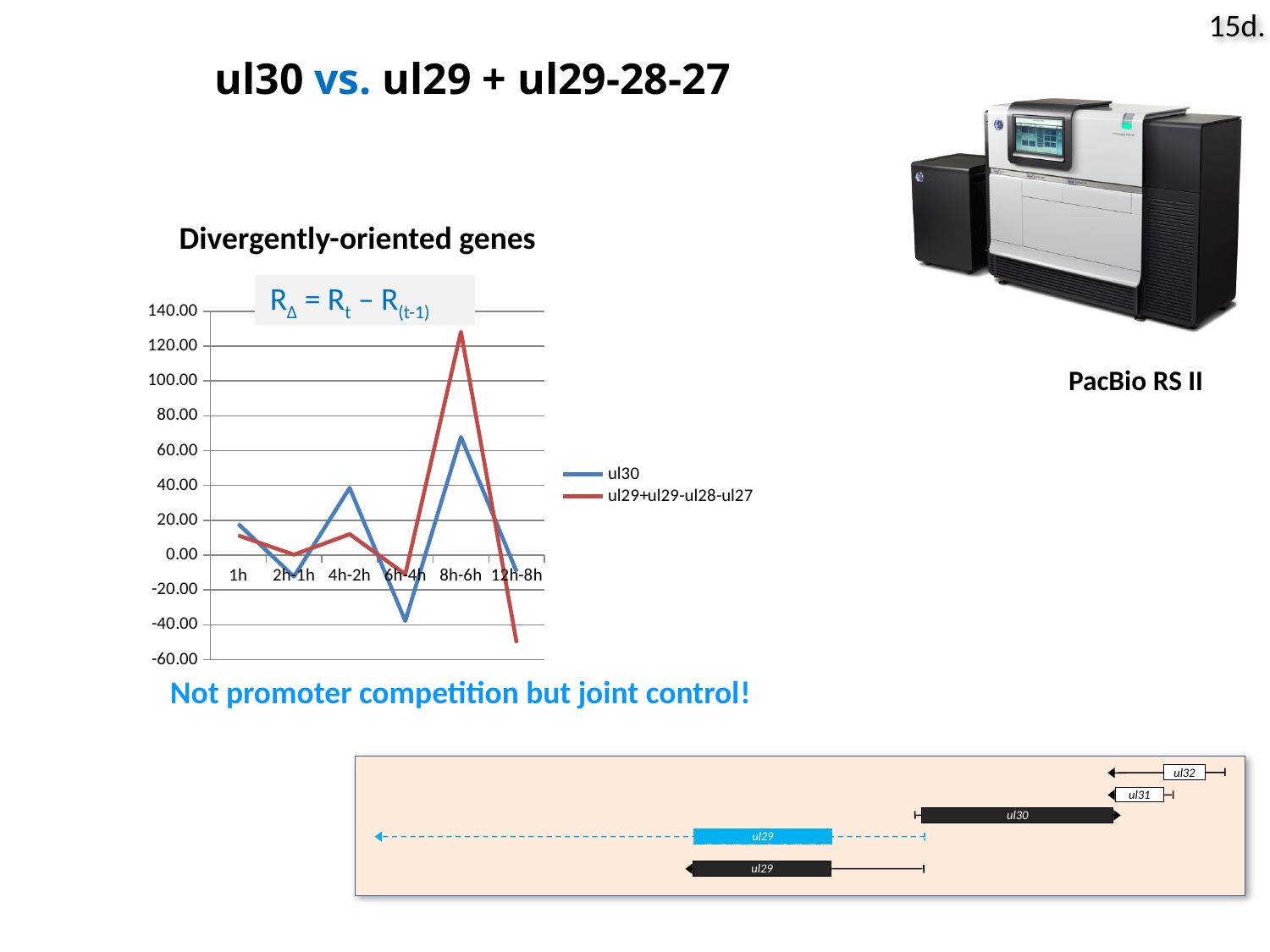
Is the value of ul29+ul29-ul28-ul27 at 8h-6h greater or less than 100.00? greater What kind of chart is shown under the heading "Divergently-oriented genes"? line chart At which x-axis category does the ul29+ul29-ul28-ul27 series reach its lowest value? 12h-8h At 8h-6h, which series has the higher value, ul30 or ul29+ul29-ul28-ul27? ul29+ul29-ul28-ul27 Is the value of ul30 at 4h-2h greater or less than 20.00? greater How many categories are shown on the x axis of the line chart? 6 Which series in the line chart is drawn in red? ul29+ul29-ul28-ul27 How many series does the legend of the line chart list? 2 Is the value of ul30 at 6h-4h greater or less than -20.00? less At 4h-2h, which series has the higher value, ul30 or ul29+ul29-ul28-ul27? ul30 At which x-axis category does the ul30 series reach its lowest value? 6h-4h At which x-axis category does the ul29+ul29-ul28-ul27 series reach its highest value? 8h-6h